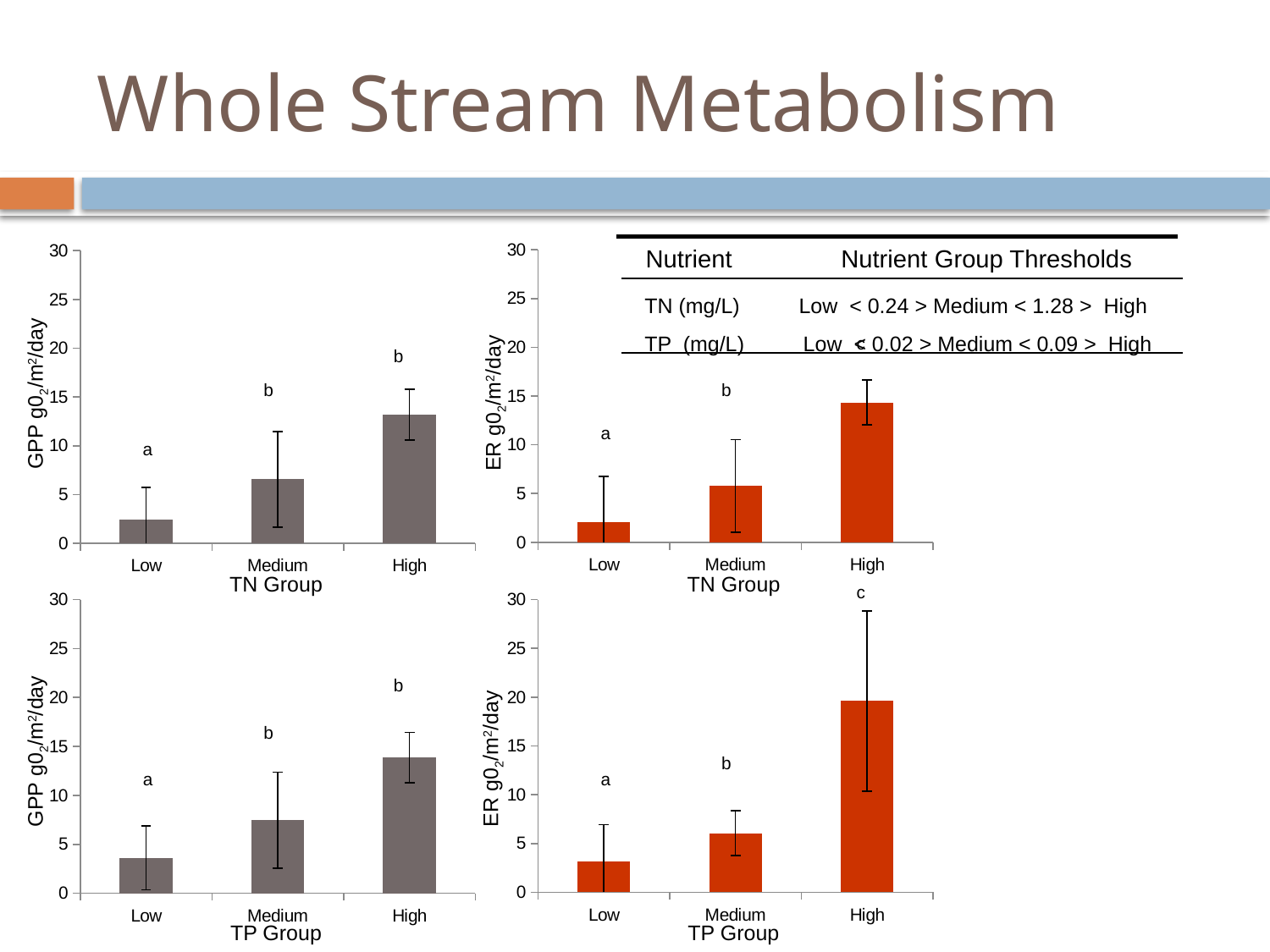
In the bottom-right chart (ER by TP Group), which TP group has the lowest ER value? Low What kind of chart is the top-right chart (ER by TN Group)? bar chart In the bottom-left chart (GPP by TP Group), is the value for the Medium group greater or less than 5? greater In the top-left chart (GPP by TN Group), is the value for the High group greater or less than 10? greater In the top-left chart (GPP by TN Group), which TN group has the lowest GPP value? Low In the top-left chart (GPP by TN Group), which TN group has the highest GPP value? High In the bottom-right chart (ER by TP Group), is the value for the High group greater or less than 15? greater In the bottom-right chart (ER by TP Group), do the values rise or fall from Low to High along the x axis? rise How many categories are shown on the x axis of the top-left chart (GPP by TN Group)? 3 In the top-right chart (ER by TN Group), which TN group has the highest ER value? High In the bottom-left chart (GPP by TP Group), which is larger, the value for Low or the value for Medium? Medium